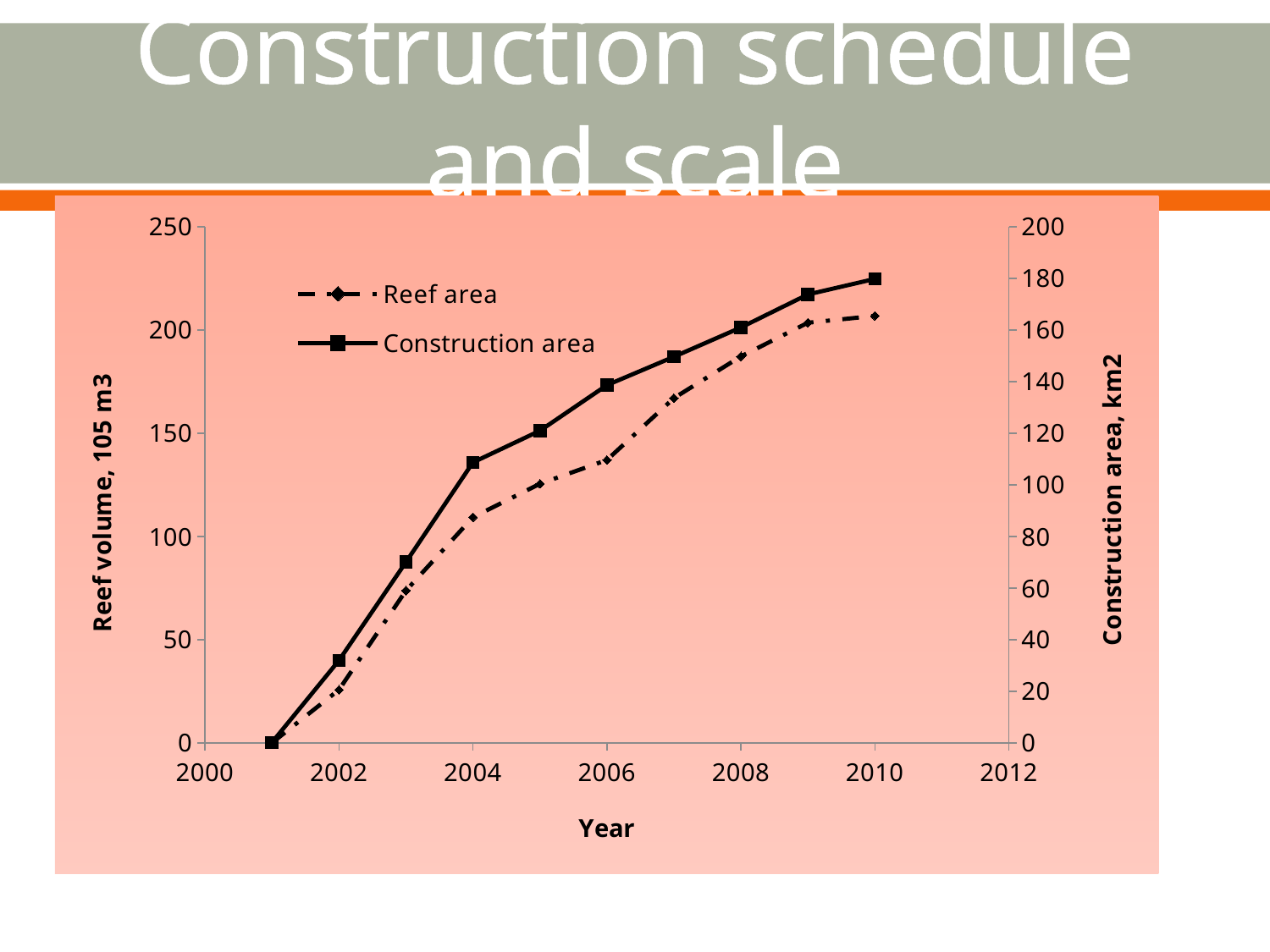
What are the two series named in the legend? Reef area and Construction area What is the title of the left vertical axis? Reef volume, 105 m3 What kind of chart is shown on the slide? line chart Does the Construction area series rise or fall from 2001 to 2010? rise How many data points are plotted for the Construction area series? 10 Is the Construction area value in 2004 greater or less than 100 on the right axis? greater Is the Reef area value in 2002 greater or less than 50 on the left axis? less How many series does the legend list? 2 Is the Reef area value in 2006 greater or less than 150 on the left axis? less In which year is the Reef area series at its lowest value? 2001 In which year does the Construction area series reach its highest value? 2010